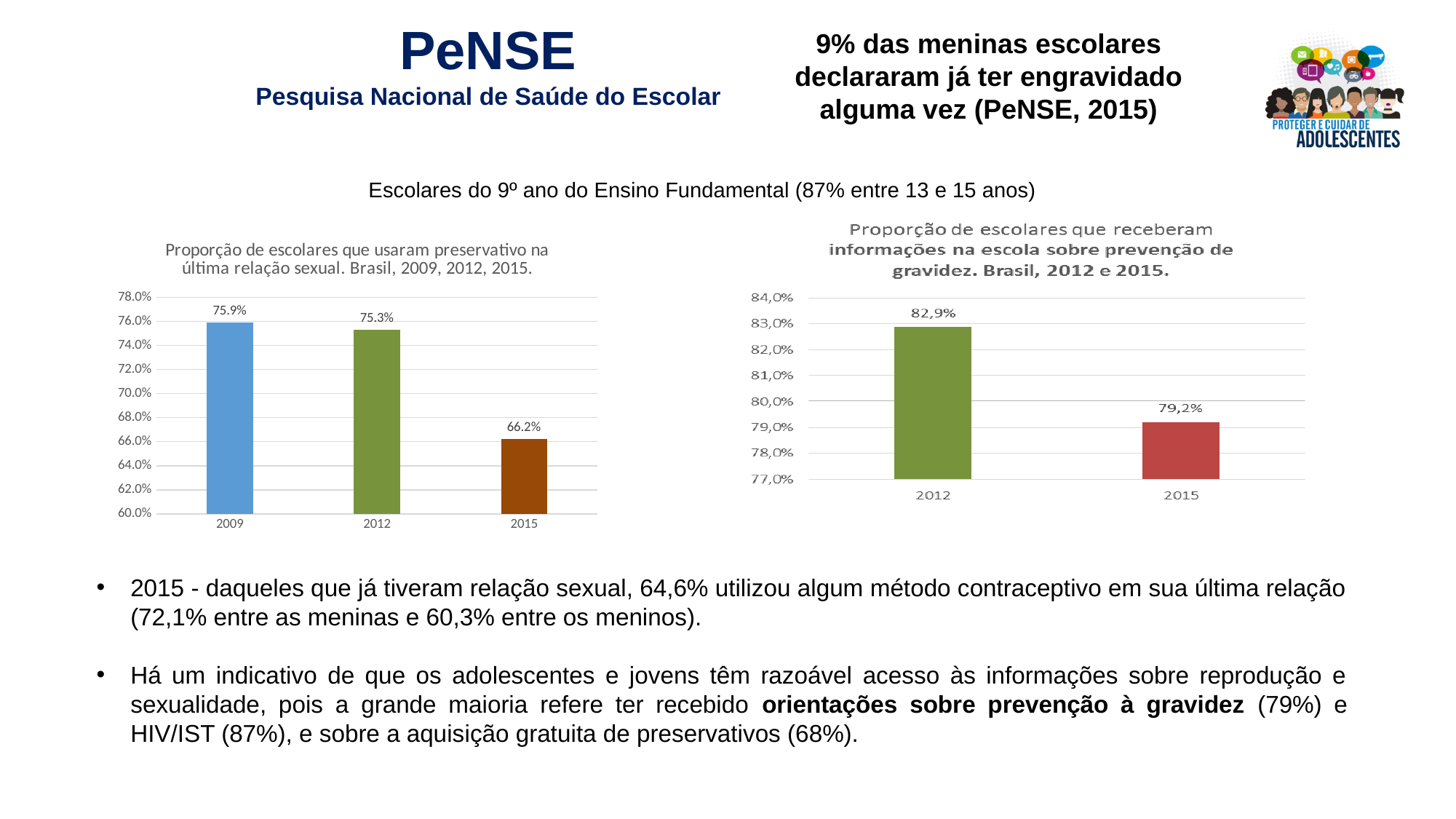
What type of chart is the right chart on information about pregnancy prevention received at school? bar chart In the right chart on information about pregnancy prevention received at school, what is the value for 2015? 79,2% In the right chart on information about pregnancy prevention received at school, what is the value for 2012? 82,9% In the left chart on condom use in the last sexual relation, do the values rise or fall from 2009 to 2015? fall In the left chart on condom use in the last sexual relation, what is the value for 2009? 75.9% In the left chart on condom use in the last sexual relation, what is the value for 2015? 66.2% In the left chart on condom use in the last sexual relation, which year has the lowest value? 2015 In the right chart on information about pregnancy prevention received at school, what is the difference between the 2012 and 2015 values? 3,7 percentage points In the left chart on condom use in the last sexual relation, how many years are plotted? 3 In the right chart on information about pregnancy prevention received at school, which year has the larger value, 2012 or 2015? 2012 In the left chart on condom use in the last sexual relation, what is the difference between the 2009 and 2015 values? 9.7 percentage points In the left chart on condom use in the last sexual relation, which year has the highest value? 2009